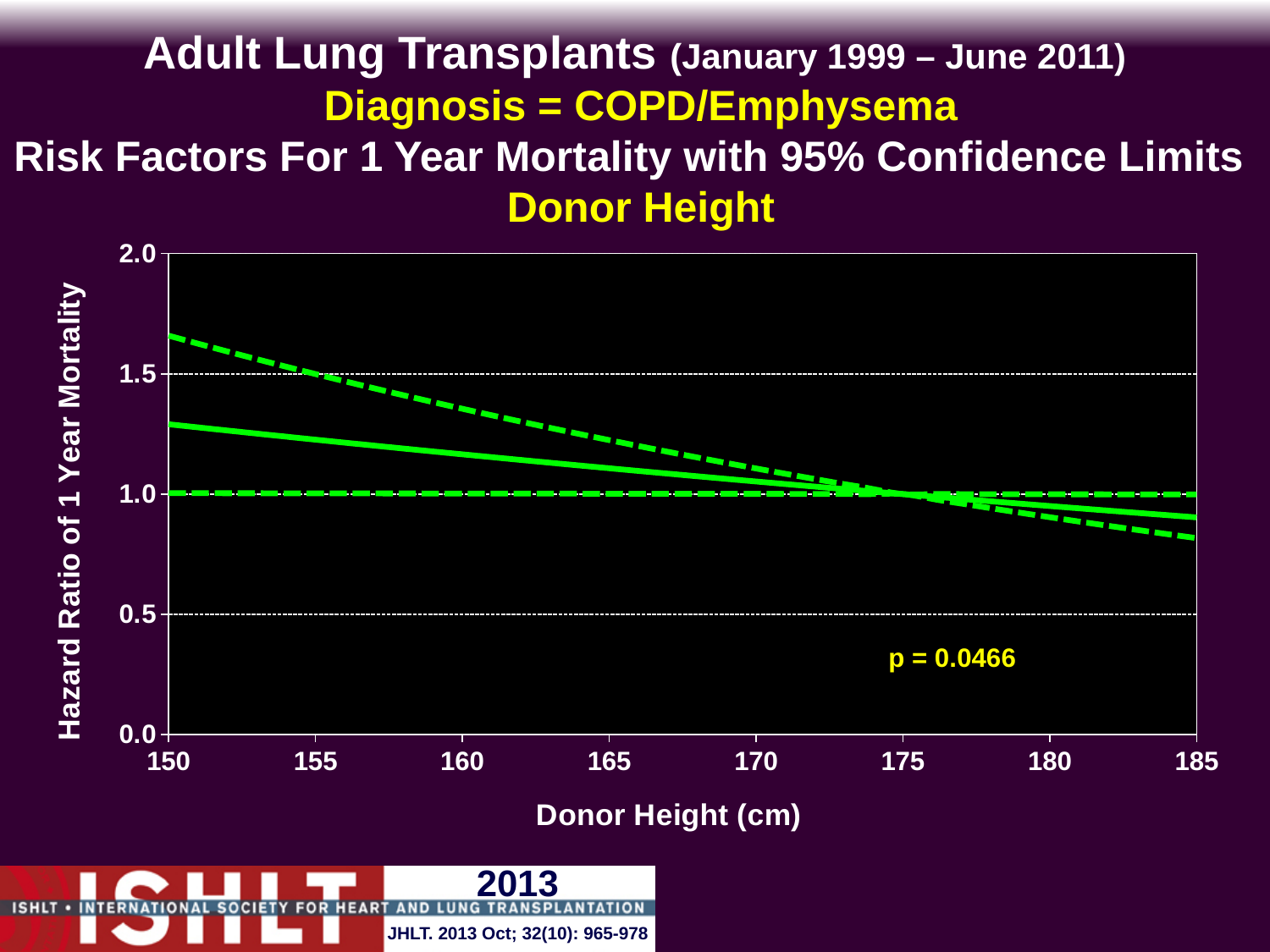
What is the label of the y axis? Hazard Ratio of 1 Year Mortality Is the upper dashed confidence limit at a donor height of 150 cm greater or less than 1.5? greater Is the upper dashed confidence limit at a donor height of 160 cm greater or less than 1.5? less Is the hazard ratio on the solid line at a donor height of 185 cm greater or less than 1.0? less Does the solid hazard ratio line rise or fall as donor height increases from 150 cm to 185 cm? fall At which donor height shown on the x axis is the solid hazard ratio line at its highest? 150 What p-value is printed on the chart? p = 0.0466 Is the hazard ratio on the solid line higher at a donor height of 150 cm or at 185 cm? 150 cm What kind of chart is shown on the slide? line chart How many lines are plotted on the chart? 3